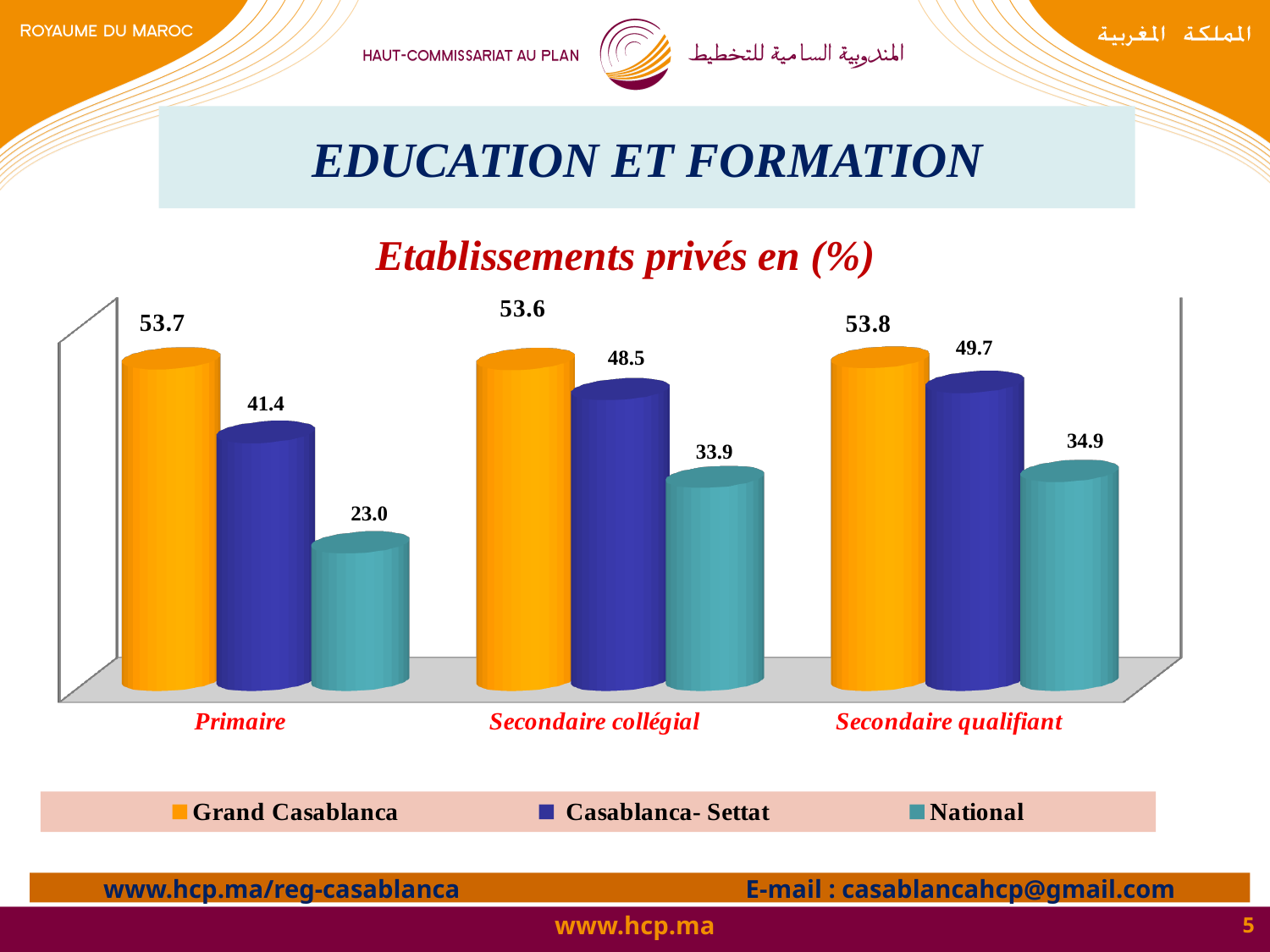
How many categories are shown on the x axis? 3 Which category has the highest value for the Casablanca- Settat series? Secondaire qualifiant What is the difference between the Casablanca- Settat values for Secondaire qualifiant and Primaire? 8.3 How many series does the legend list? 3 What kind of chart is shown on the slide? Bar chart What is the title of the chart? Etablissements privés en (%) What is the value for National in the Secondaire collégial category? 33.9 Which is larger: the National value for Secondaire collégial or for Secondaire qualifiant? Secondaire qualifiant Which category has the lowest value for the National series? Primaire What is the value for Grand Casablanca in the Primaire category? 53.7 What is the value for Casablanca- Settat in the Secondaire qualifiant category? 49.7 What is the difference between the Grand Casablanca and National values in the Primaire category? 30.7